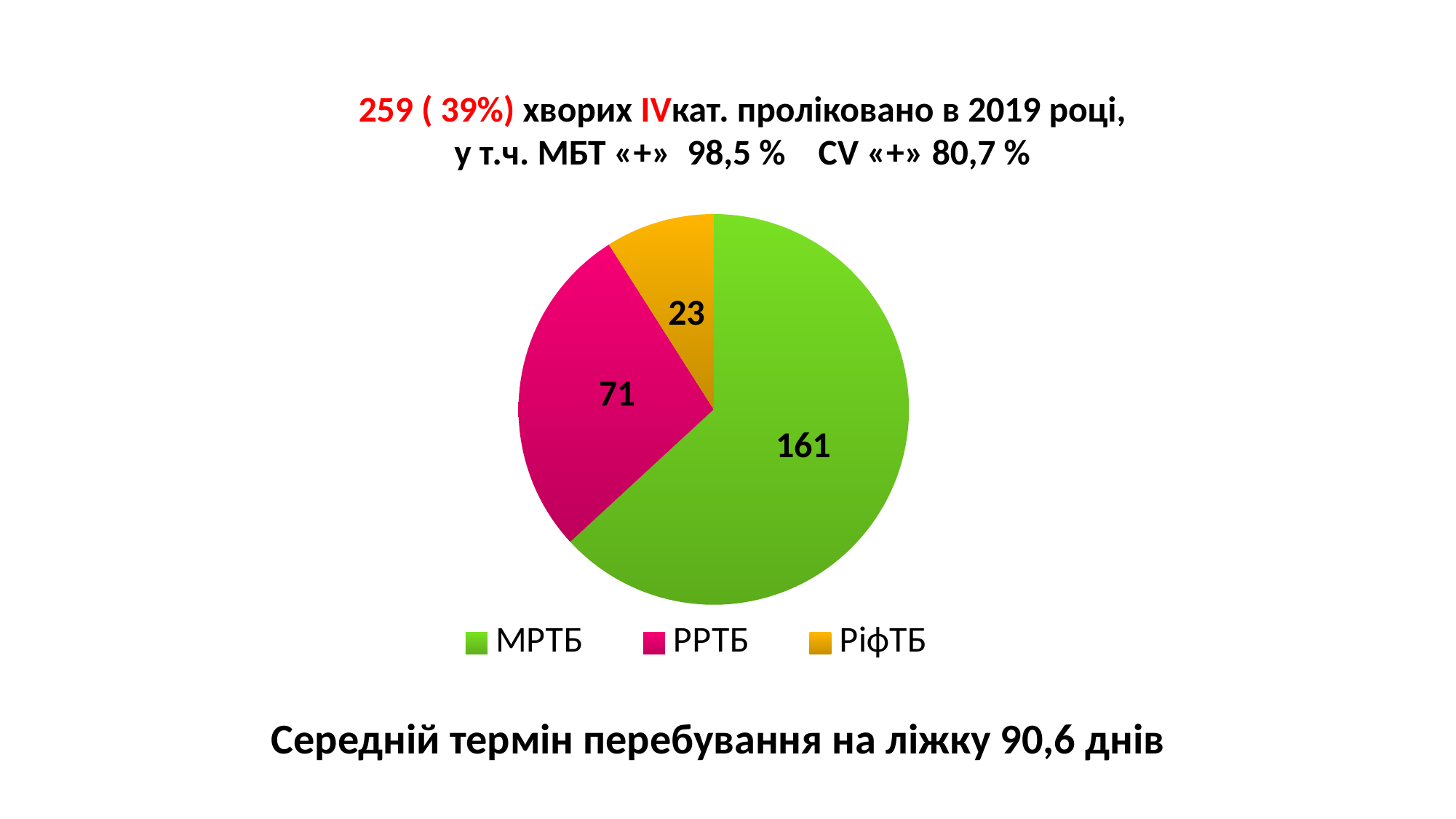
What is the value for РіфТБ in the pie chart? 23 What is the difference between the values for РРТБ and РіфТБ? 48 Which category has the largest slice in the pie chart? МРТБ Which category has the smallest slice in the pie chart? РіфТБ What is the value for МРТБ in the pie chart? 161 How many entries does the legend list? 3 How many slices does the pie chart have? 3 What colour is the МРТБ slice in the pie chart? green Which is larger, the value for РРТБ or the value for РіфТБ? РРТБ What is the difference between the values for МРТБ and РРТБ? 90 What type of chart is shown on the slide? pie chart What is the value for РРТБ in the pie chart? 71